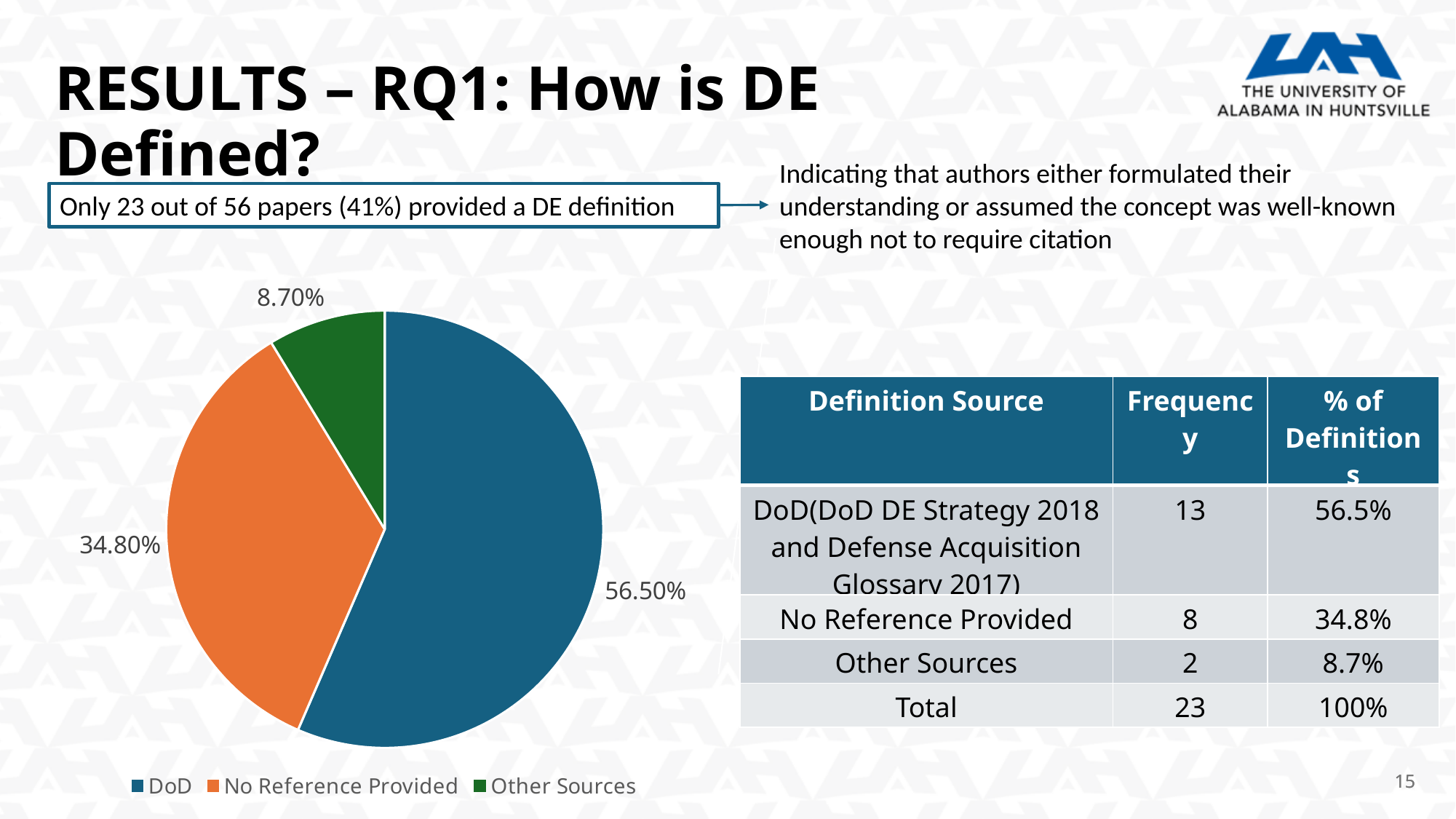
Which slice is larger, No Reference Provided or Other Sources? No Reference Provided Which category has the smallest slice of the pie? Other Sources What share of the pie does the DoD slice represent? 56.50% What share of the pie does the No Reference Provided slice represent? 34.80% How many entries does the legend list? 3 How many slices does the pie chart have? 3 What colour is the DoD slice in the pie chart? blue What share of the pie does the Other Sources slice represent? 8.70% What colour is the Other Sources slice in the pie chart? green What is the difference in percentage points between the DoD slice and the No Reference Provided slice? 21.70% Which category has the largest slice of the pie? DoD What kind of chart is shown on the slide? pie chart